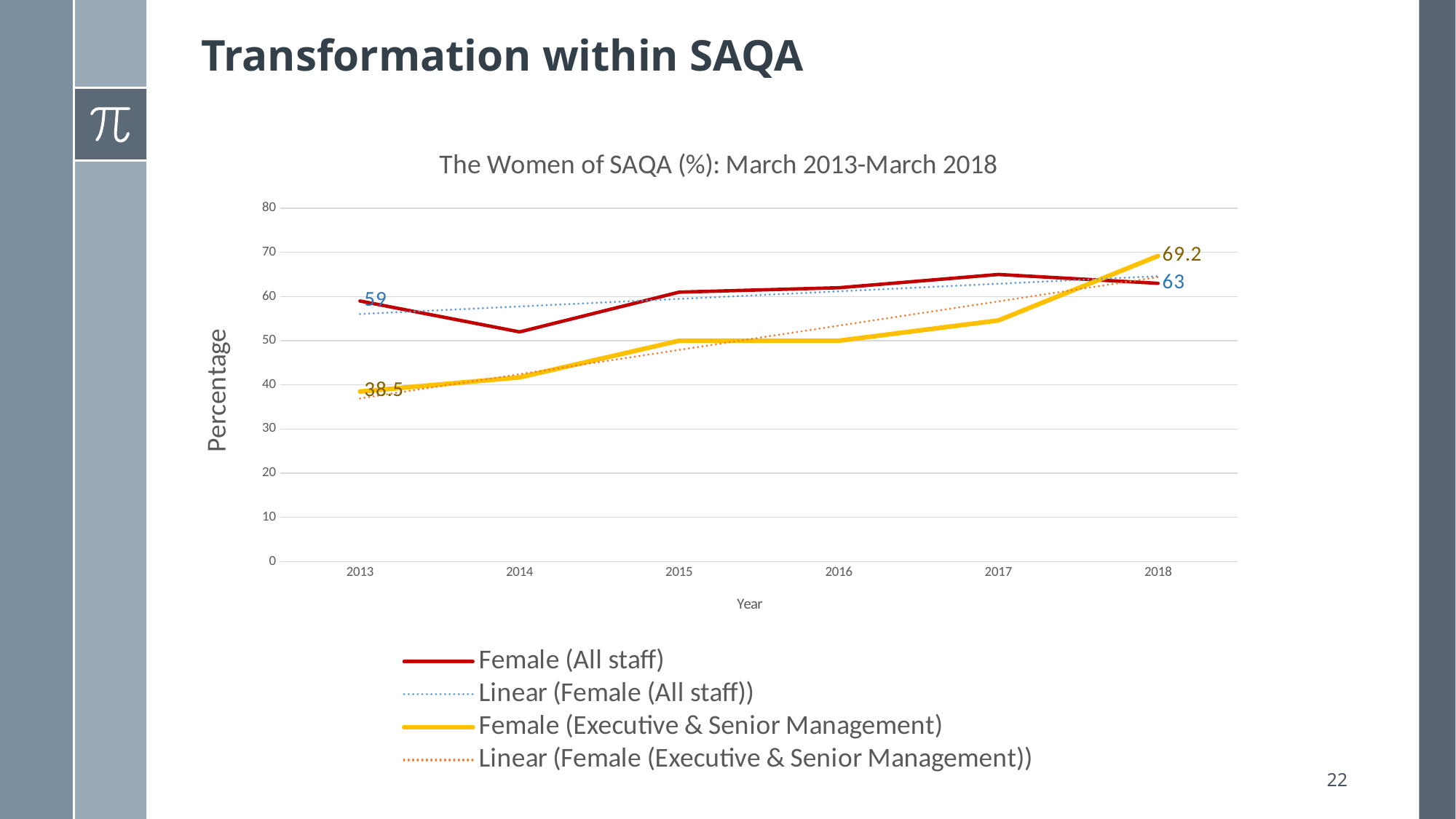
How many entries does the legend list? 4 In 2018, which is larger: Female (All staff) or Female (Executive & Senior Management)? Female (Executive & Senior Management) How many years are shown on the x axis? 6 What kind of chart is shown on the slide? Line chart In which year is the Female (All staff) value lowest? 2014 What is the value for Female (Executive & Senior Management) in 2018? 69.2 What is the value for Female (All staff) in 2013? 59 Is the value for Female (All staff) in 2017 greater or less than 60? greater By how much did the Female (Executive & Senior Management) value increase from 2013 to 2018? 30.7 What is the difference between the Female (Executive & Senior Management) and Female (All staff) values in 2018? 6.2 What is the value for Female (All staff) in 2018? 63 What is the value for Female (Executive & Senior Management) in 2013? 38.5